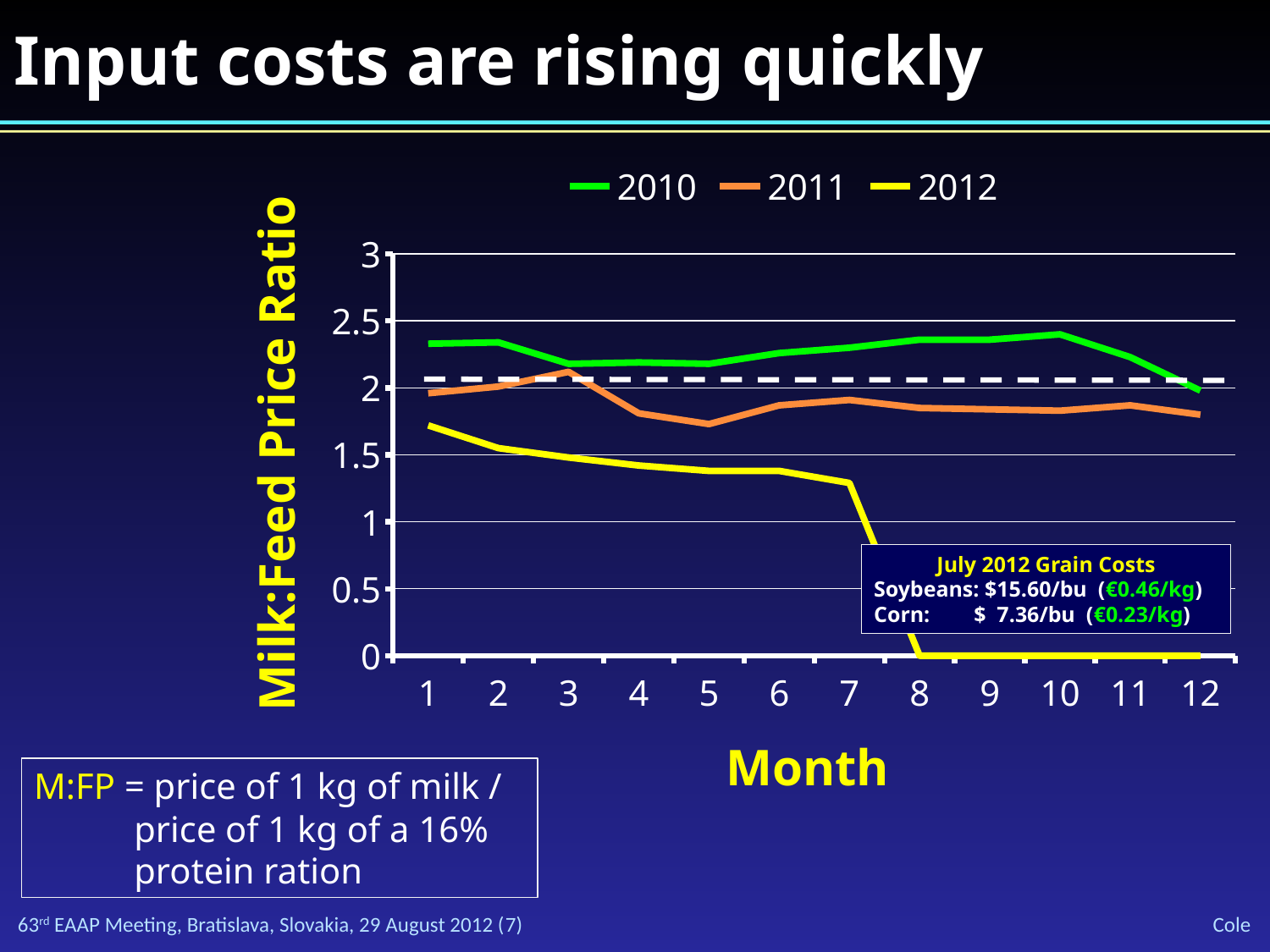
Does the 2012 line rise or fall from month 1 to month 12? fall Is the 2010 value at month 1 greater or less than 2? greater At month 8, which series has the higher value, 2011 or 2012? 2011 What is the title of the y axis? Milk:Feed Price Ratio Is the 2012 value at month 1 greater or less than 2? less Is the 2012 value at month 7 greater or less than 1.5? less At month 1, which series has the higher value, 2010 or 2012? 2010 Which series has the highest values across the months? 2010 What kind of chart is shown on the slide? line chart How many months are shown along the x axis? 12 How many series does the legend list? 3